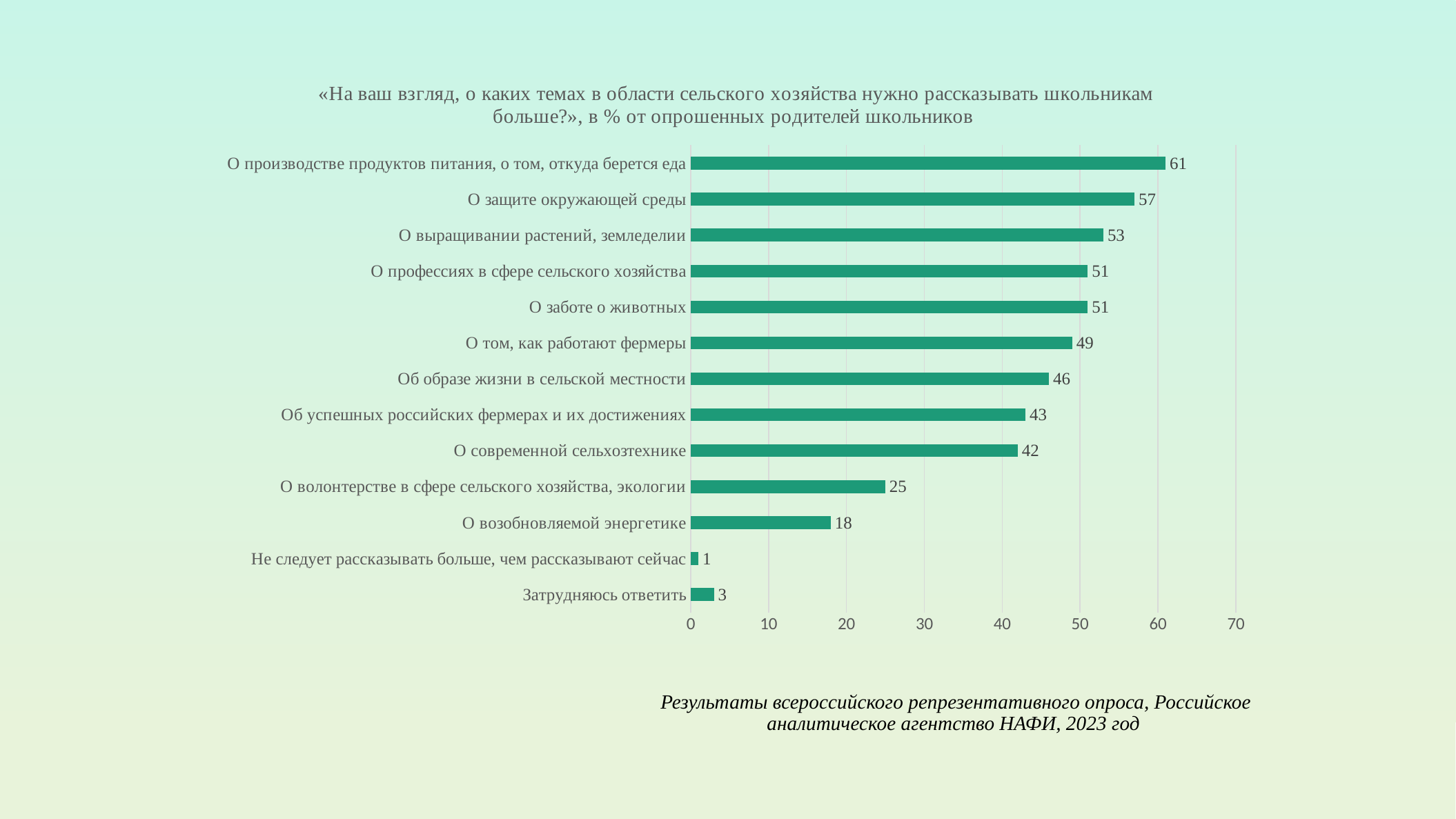
What value is shown for «О возобновляемой энергетике»? 18 Is the value for «О том, как работают фермеры» greater or less than 40? greater What value is shown for «О защите окружающей среды»? 57 What is the difference between the values for «О производстве продуктов питания, о том, откуда берется еда» and «О защите окружающей среды»? 4 Which is larger: the value for «Об образе жизни в сельской местности» or for «Об успешных российских фермерах и их достижениях»? Об образе жизни в сельской местности What is the maximum value shown on the horizontal axis? 70 What kind of chart is shown on the slide? bar chart How many categories are shown in the chart? 13 What value is shown for «О волонтерстве в сфере сельского хозяйства, экологии»? 25 What is the difference between the values for «О современной сельхозтехнике» and «О возобновляемой энергетике»? 24 Which category has the lowest value? Не следует рассказывать больше, чем рассказывают сейчас Which category has the highest value? О производстве продуктов питания, о том, откуда берется еда